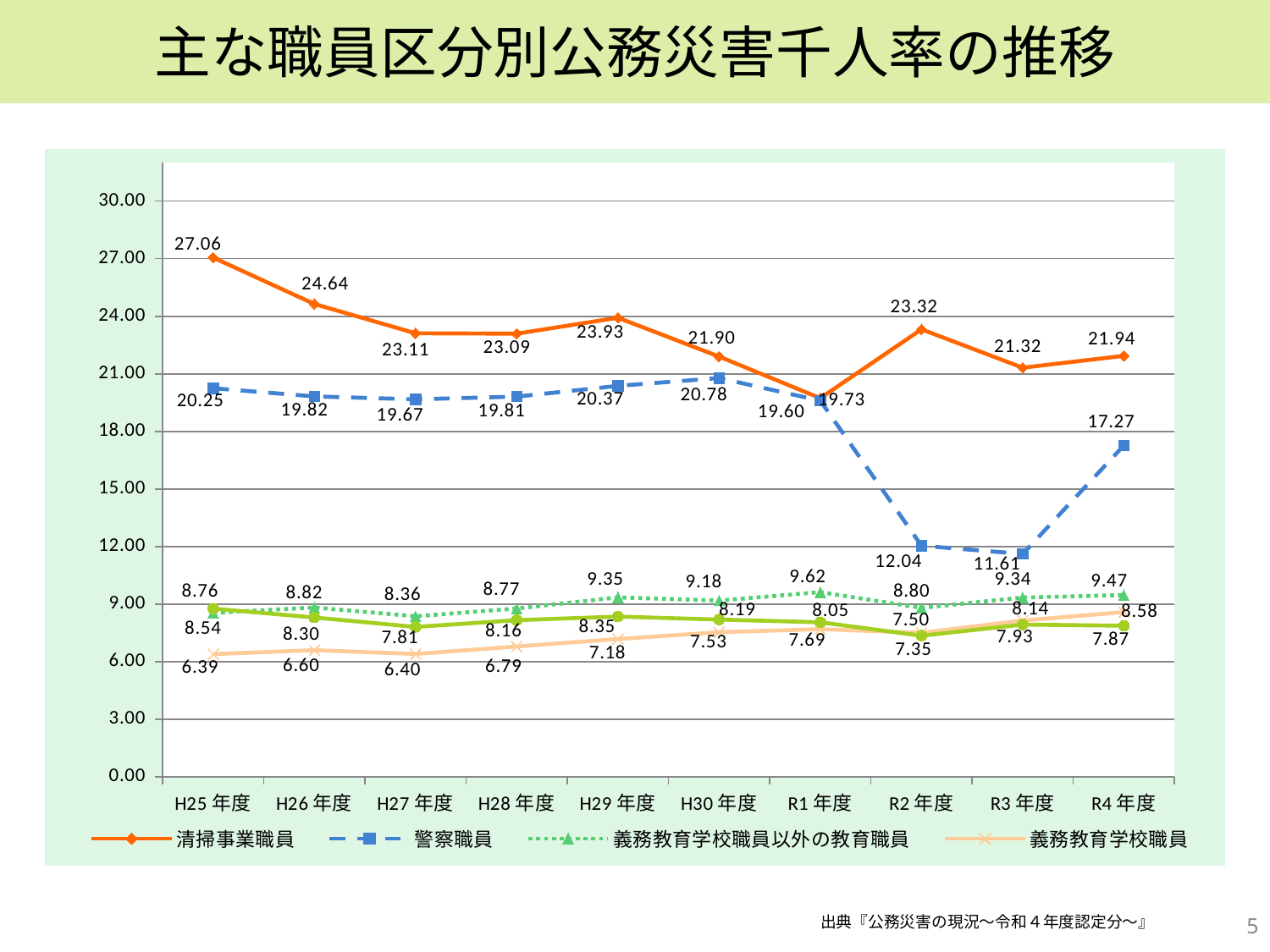
In H30 年度, which is larger: 清掃事業職員 or 警察職員? 清掃事業職員 What is the difference between the 清掃事業職員 values in H25 年度 and R4 年度? 5.12 What is the value for 義務教育学校職員以外の教育職員 in R1 年度? 9.62 In which year is the value for 警察職員 lowest? R3 年度 Is the value for 警察職員 in R2 年度 greater or less than 15.00? less What is the value for 義務教育学校職員 in R4 年度? 8.58 What is the value for 警察職員 in R3 年度? 11.61 In which year is the value for 清掃事業職員 highest? H25 年度 How many years are shown on the x axis? 10 What is the value for 清掃事業職員 in H25 年度? 27.06 What kind of chart is shown on the slide? line chart How many series does the legend list? 4